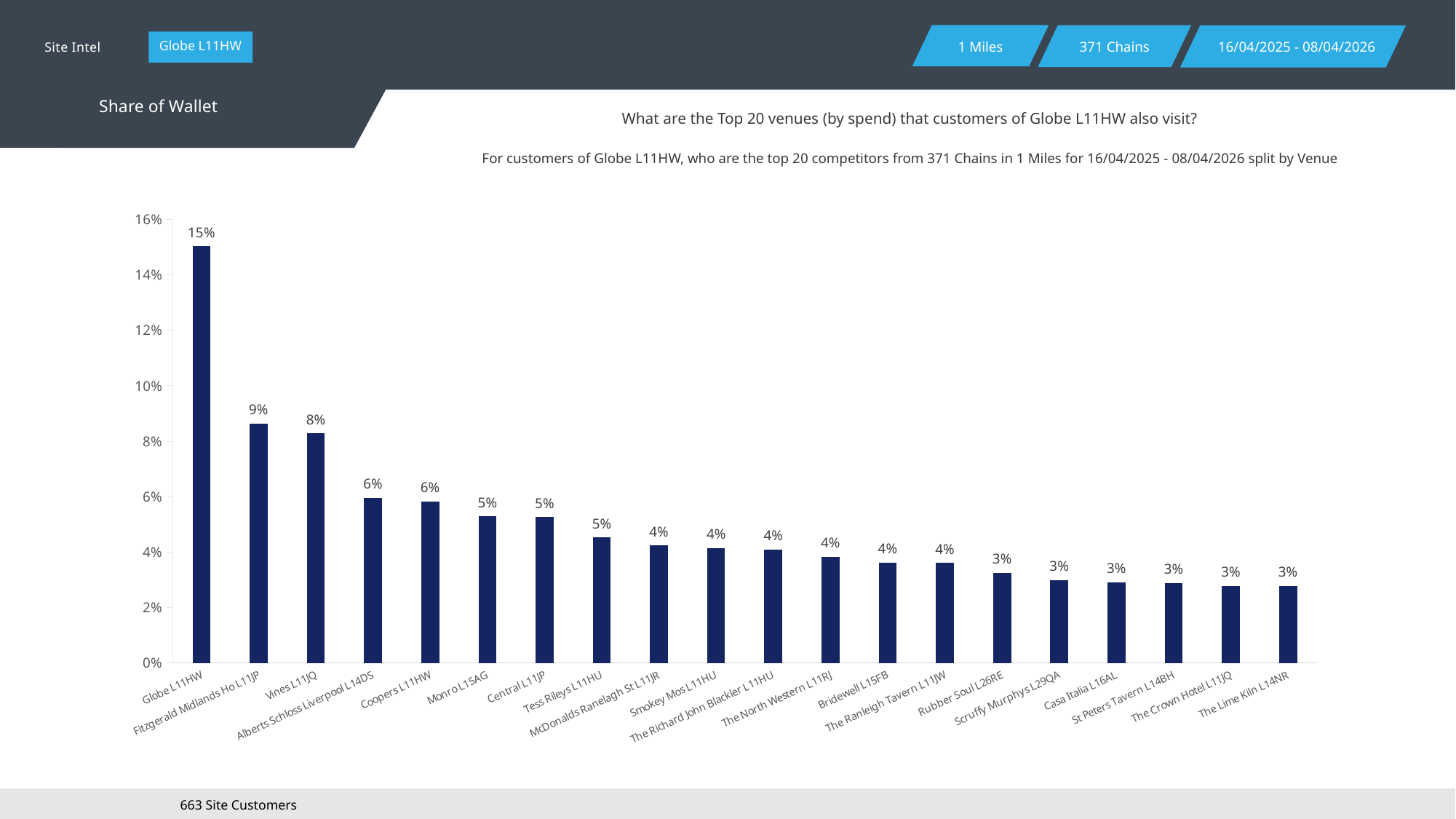
How many venues are shown on the chart? 20 What is the value for The Lime Kiln L14NR? 3% What is the value for Fitzgerald Midlands Ho L11JP? 9% What is the value for Globe L11HW? 15% Which is larger, the value for Fitzgerald Midlands Ho L11JP or the value for Alberts Schloss Liverpool L14DS? Fitzgerald Midlands Ho L11JP What is the value for Vines L11JQ? 8% What is the difference between the values for Globe L11HW and Fitzgerald Midlands Ho L11JP? 6% Do the values rise or fall from left to right along the x axis? fall What is the value for Tess Rileys L11HU? 5% Is the value for Vines L11JQ greater or less than 10%? less Which venue has the highest value? Globe L11HW What kind of chart is shown on the slide? bar chart